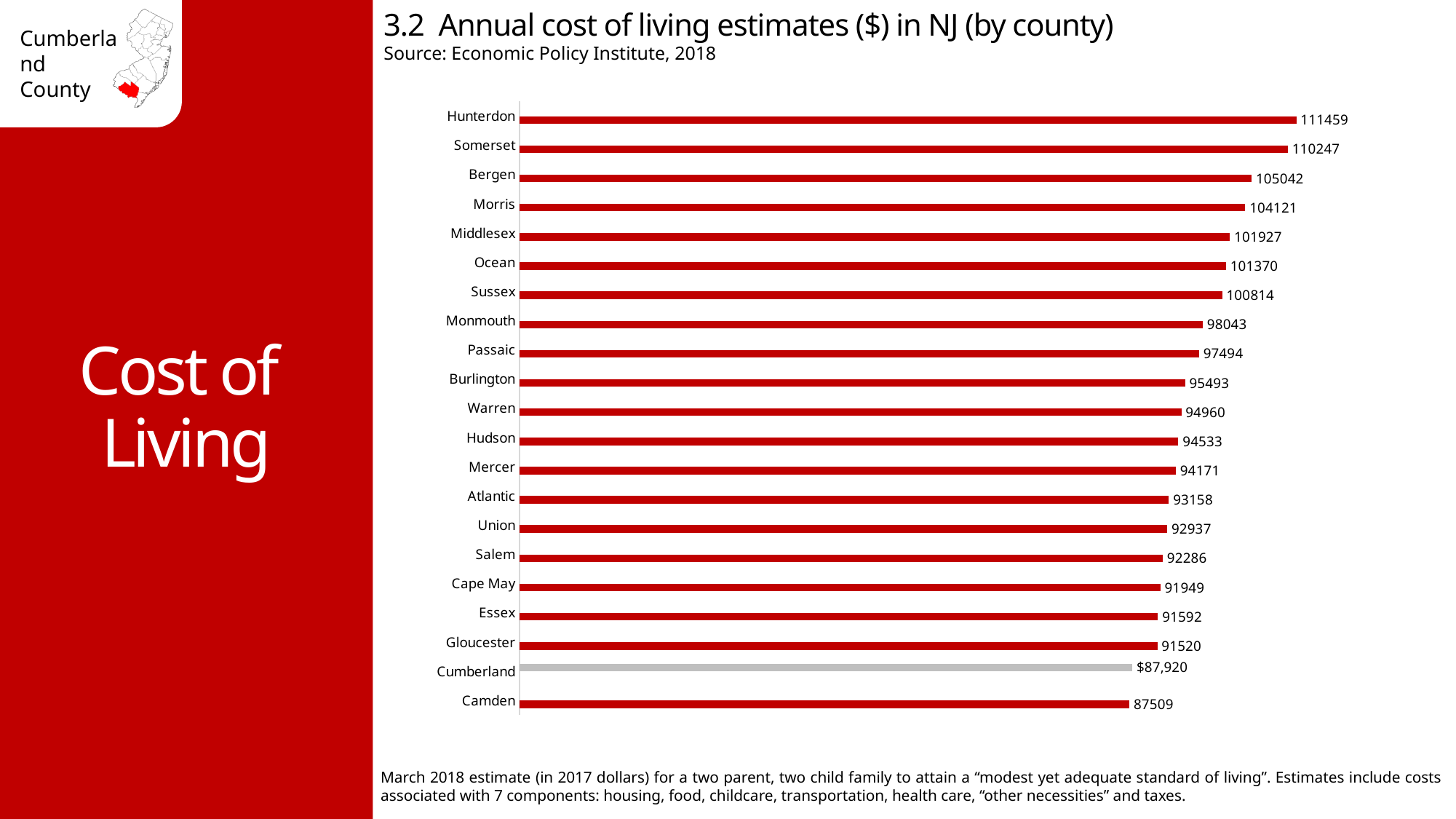
What is the annual cost of living estimate for Hunterdon county? 111459 Which county has the lowest annual cost of living estimate? Camden How many counties are shown in the chart? 21 What is the annual cost of living estimate for Monmouth county? 98043 What is the difference between the cost of living estimates for Hunterdon and Camden? 23950 What is the annual cost of living estimate for Salem county? 92286 What is the difference between the cost of living estimates for Hunterdon and Somerset? 1212 Which county has the highest annual cost of living estimate? Hunterdon What type of chart is shown on the slide? Bar chart Which county's bar is shown in gray rather than red? Cumberland What is the annual cost of living estimate for Cumberland county? $87,920 Which county has a higher cost of living estimate, Bergen or Passaic? Bergen